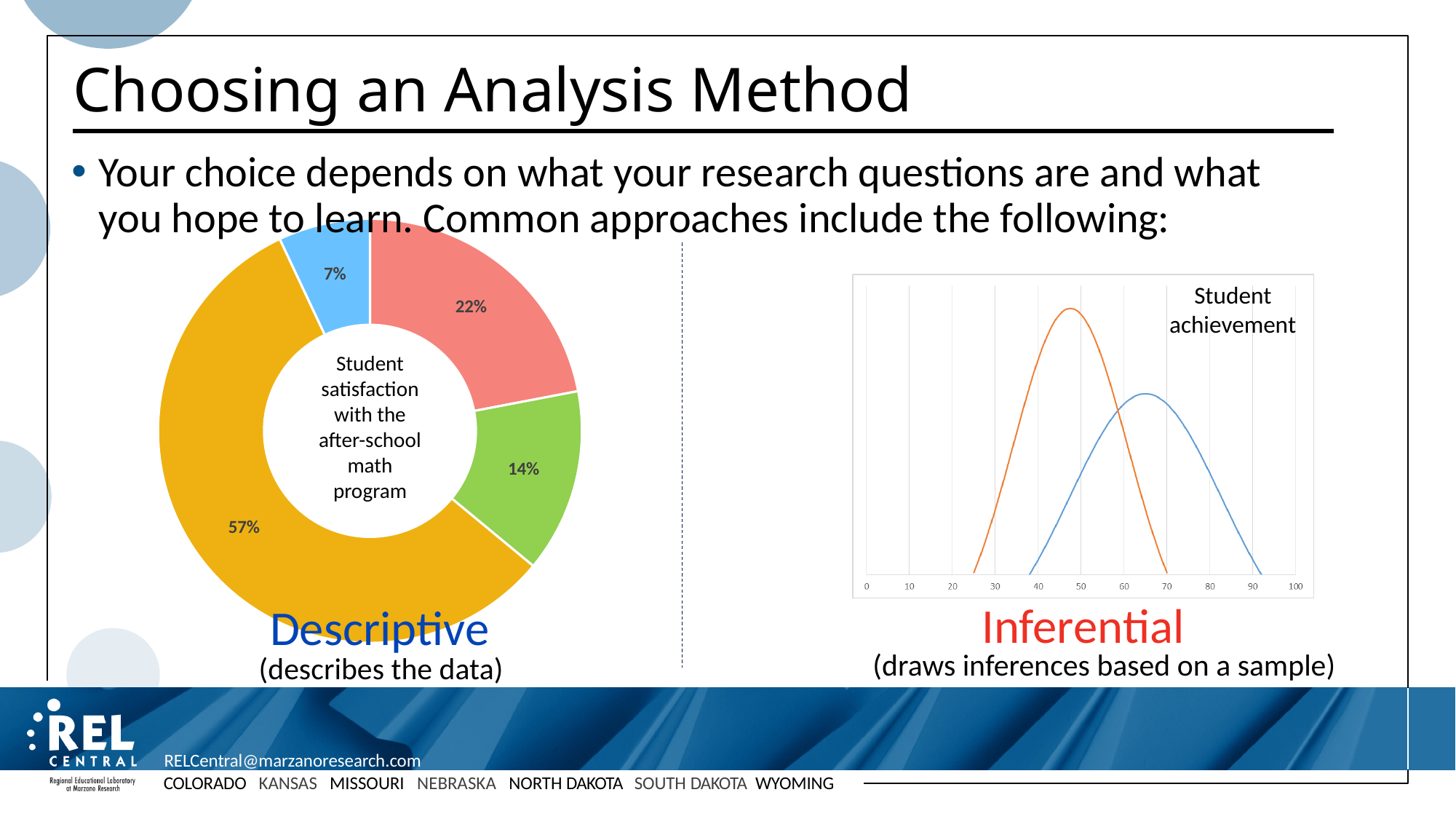
In the 'Student achievement' chart, how many curves (series) are plotted? 2 In the 'Student satisfaction with the after-school math program' chart, how many slices are there? 4 What kind of chart is the 'Student achievement' chart on the right? Line chart What kind of chart is the 'Student satisfaction with the after-school math program' chart on the left? Pie (donut) chart In the 'Student satisfaction with the after-school math program' chart, what is the value of the largest slice? 57% In the 'Student satisfaction with the after-school math program' chart, what is the difference between the largest slice and the smallest slice? 50 percentage points In the 'Student satisfaction with the after-school math program' chart, what colour is the largest slice? Yellow/orange In the 'Student satisfaction with the after-school math program' chart, what is the value of the smallest slice? 7% In the 'Student achievement' chart, which curve reaches a higher peak: the orange curve or the blue curve? The orange curve In the 'Student satisfaction with the after-school math program' chart, what percentage is shown on the green slice? 14% In the 'Student satisfaction with the after-school math program' chart, which slice is larger: the red slice or the green slice? The red slice (22%) In the 'Student satisfaction with the after-school math program' chart, what percentage is shown on the red slice? 22%